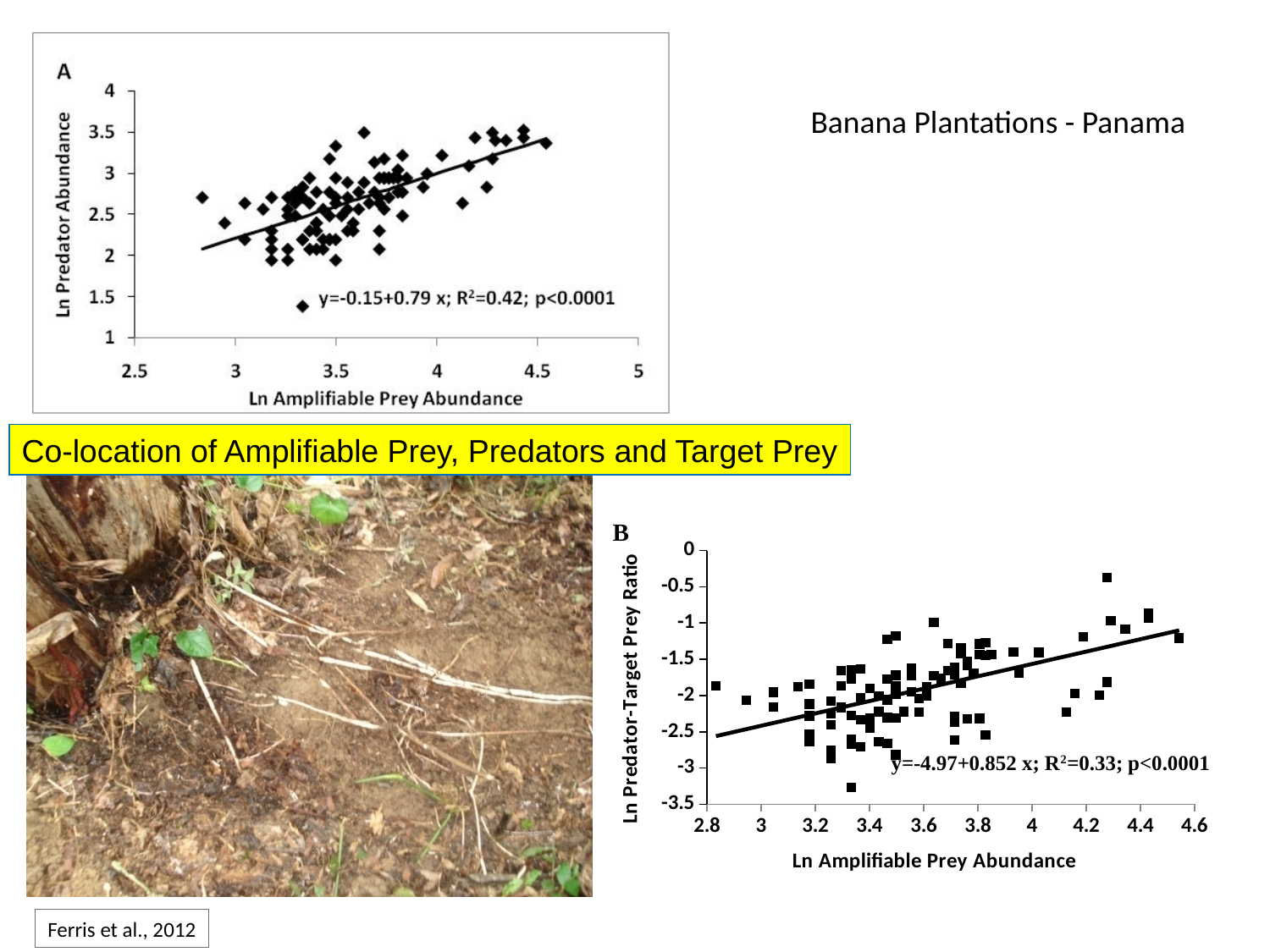
In chart A, what is the regression equation shown? y=-0.15+0.79 x In chart A, does Ln Predator Abundance tend to rise or fall as Ln Amplifiable Prey Abundance increases? rise In chart A, what is the R² value printed for the regression? 0.42 What is the y-axis label of chart B? Ln Predator-Target Prey Ratio What kind of chart is chart B (bottom right)? scatter plot In chart B, what is the regression equation shown? y=-4.97+0.852 x Which chart has the higher R² value, chart A or chart B? chart A What p-value is printed in chart B? p<0.0001 In chart B, does Ln Predator-Target Prey Ratio tend to rise or fall as Ln Amplifiable Prey Abundance increases? rise What kind of chart is chart A (top left)? scatter plot In chart B, what is the R² value printed for the regression? 0.33 What is the x-axis label of chart A? Ln Amplifiable Prey Abundance